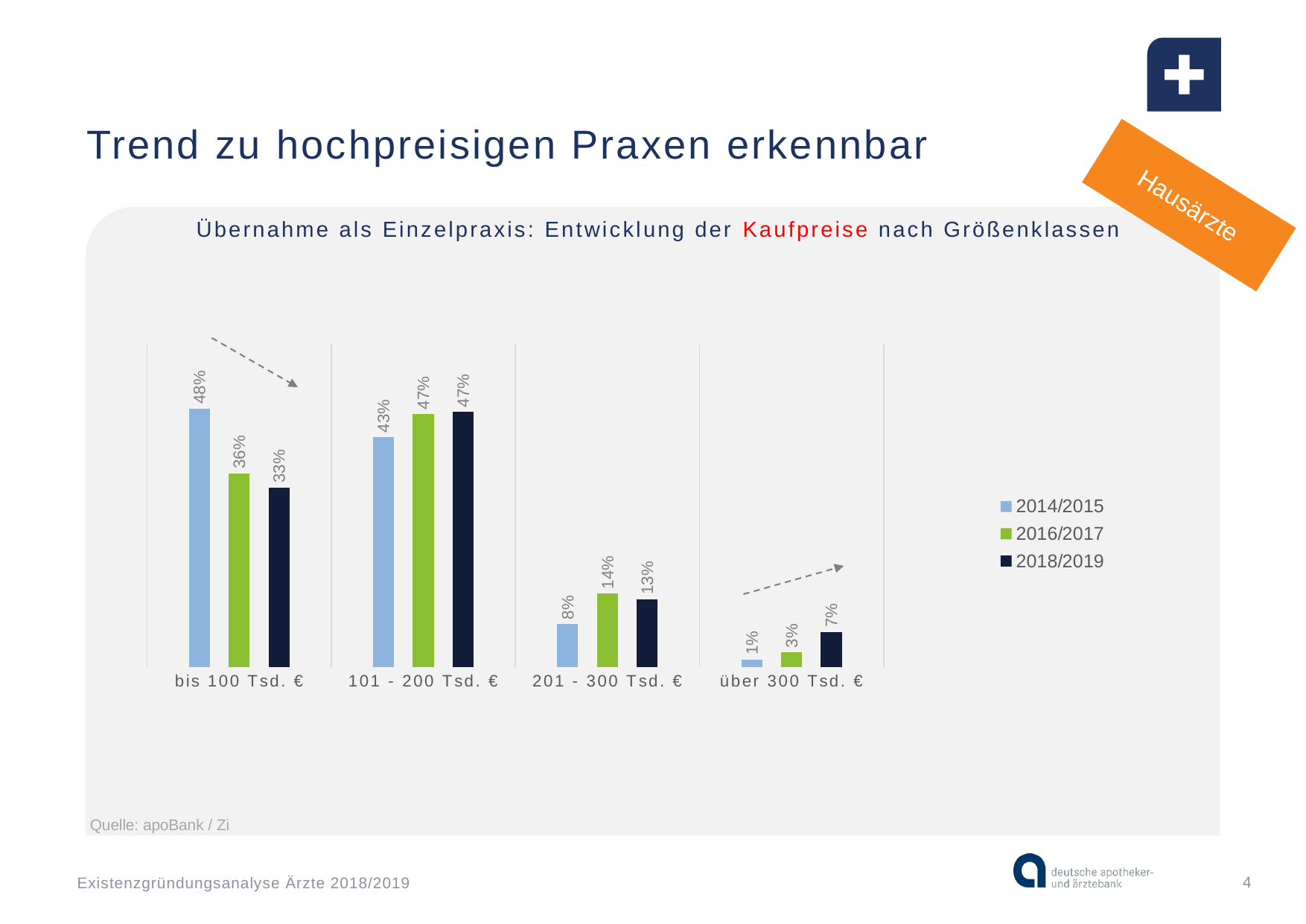
What is the difference between the 2014/2015 and 2018/2019 values in the 'bis 100 Tsd. €' category? 15% Which category has the highest value for the 2018/2019 series? 101 - 200 Tsd. € Which is larger in the '101 - 200 Tsd. €' category: the 2014/2015 value or the 2016/2017 value? 2016/2017 What is the value for 2016/2017 in the '201 - 300 Tsd. €' category? 14% How many series does the legend list? 3 What is the value for 2014/2015 in the 'bis 100 Tsd. €' category? 48% Which category has the lowest value for the 2014/2015 series? über 300 Tsd. € What is the value for 2018/2019 in the 'über 300 Tsd. €' category? 7% What kind of chart is shown on the slide? Bar chart How many size categories are shown on the x axis? 4 Do the values for the 'über 300 Tsd. €' category rise or fall from 2014/2015 to 2018/2019? Rise Which series is shown in green in the legend? 2016/2017